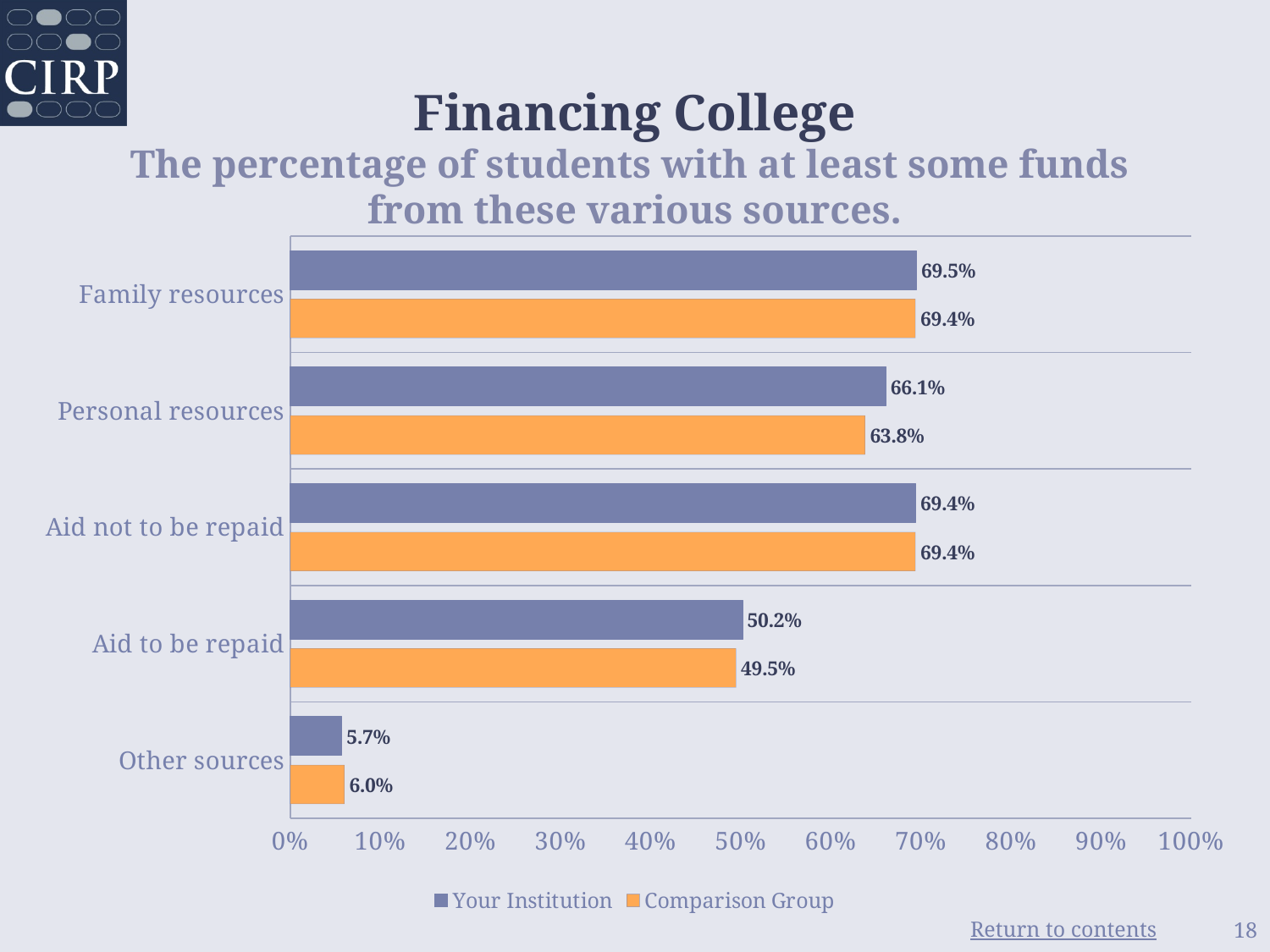
What is the value for Comparison Group for Other sources? 6.0% What is the difference between Your Institution and Comparison Group for Aid to be repaid? 0.7% Which category has the lowest value for Your Institution? Other sources What is the value for Your Institution for Personal resources? 66.1% What colour are the Comparison Group bars? Orange What is the difference between Your Institution and Comparison Group for Personal resources? 2.3% What is the value for Comparison Group for Aid to be repaid? 49.5% How many series does the legend list? 2 What kind of chart is shown on the slide? Bar chart Is the value for Your Institution for Aid to be repaid greater or less than 40%? greater Which is larger for Personal resources, Your Institution or Comparison Group? Your Institution How many categories are shown on the chart? 5